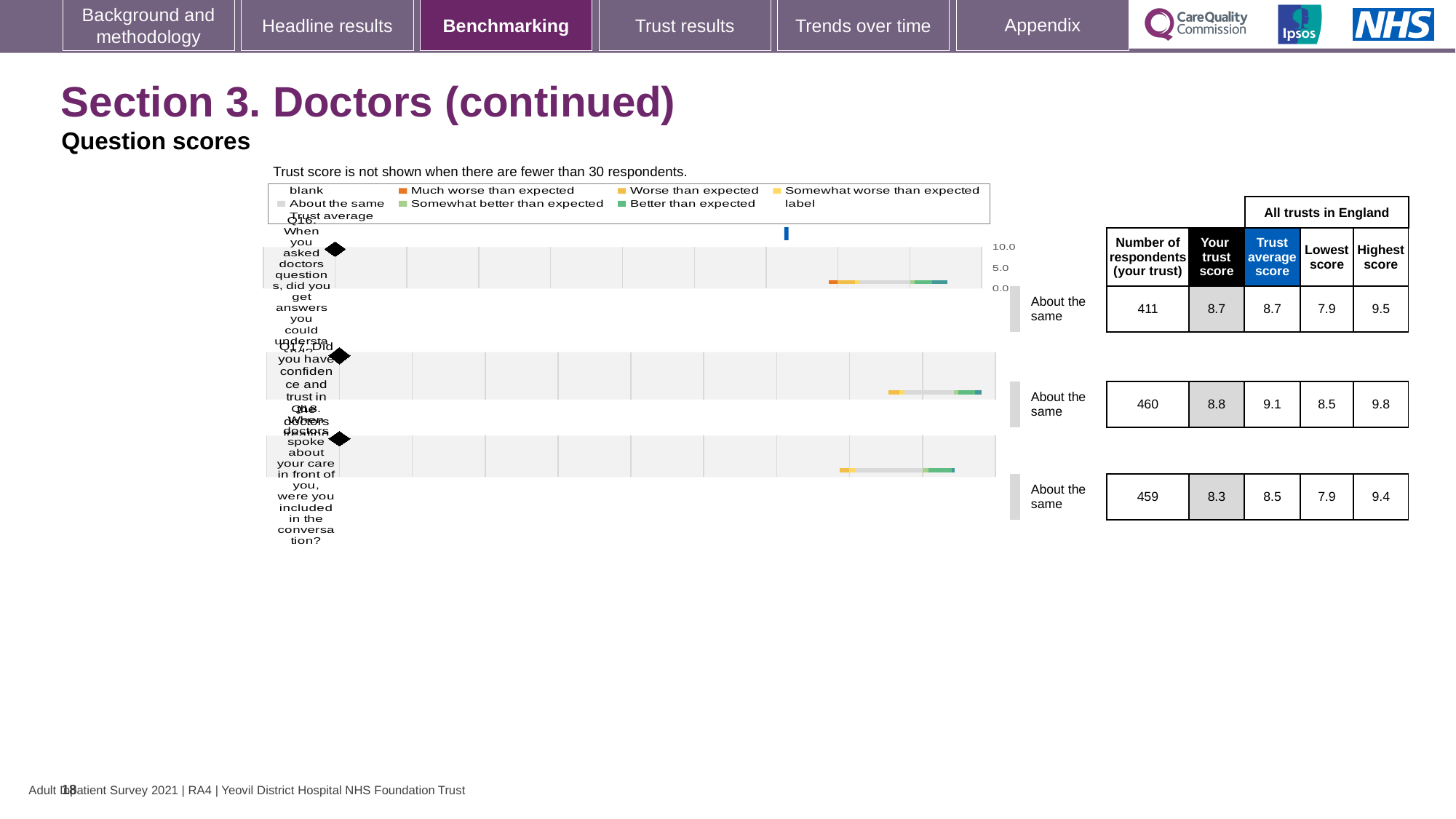
What is the trust average score for Q18? 8.5 What benchmark category is shown for Q17? About the same Which question has the lowest 'Your trust score'? Q18 What is the 'Your trust score' for Q17 (Did you have confidence and trust in the doctors treating you)? 8.8 What is the highest score across all trusts in England for Q16? 9.5 How many respondents from your trust answered Q18? 459 Which question has the highest 'Your trust score'? Q17 What is the difference between the trust average score and your trust score for Q17? 0.3 How many questions are plotted in the chart? 3 What is the difference between the highest score and the lowest score for Q16? 1.6 Which is larger, your trust score for Q16 or for Q18? Q16 Is your trust score for Q16 greater or less than 5.0 on the chart axis? greater